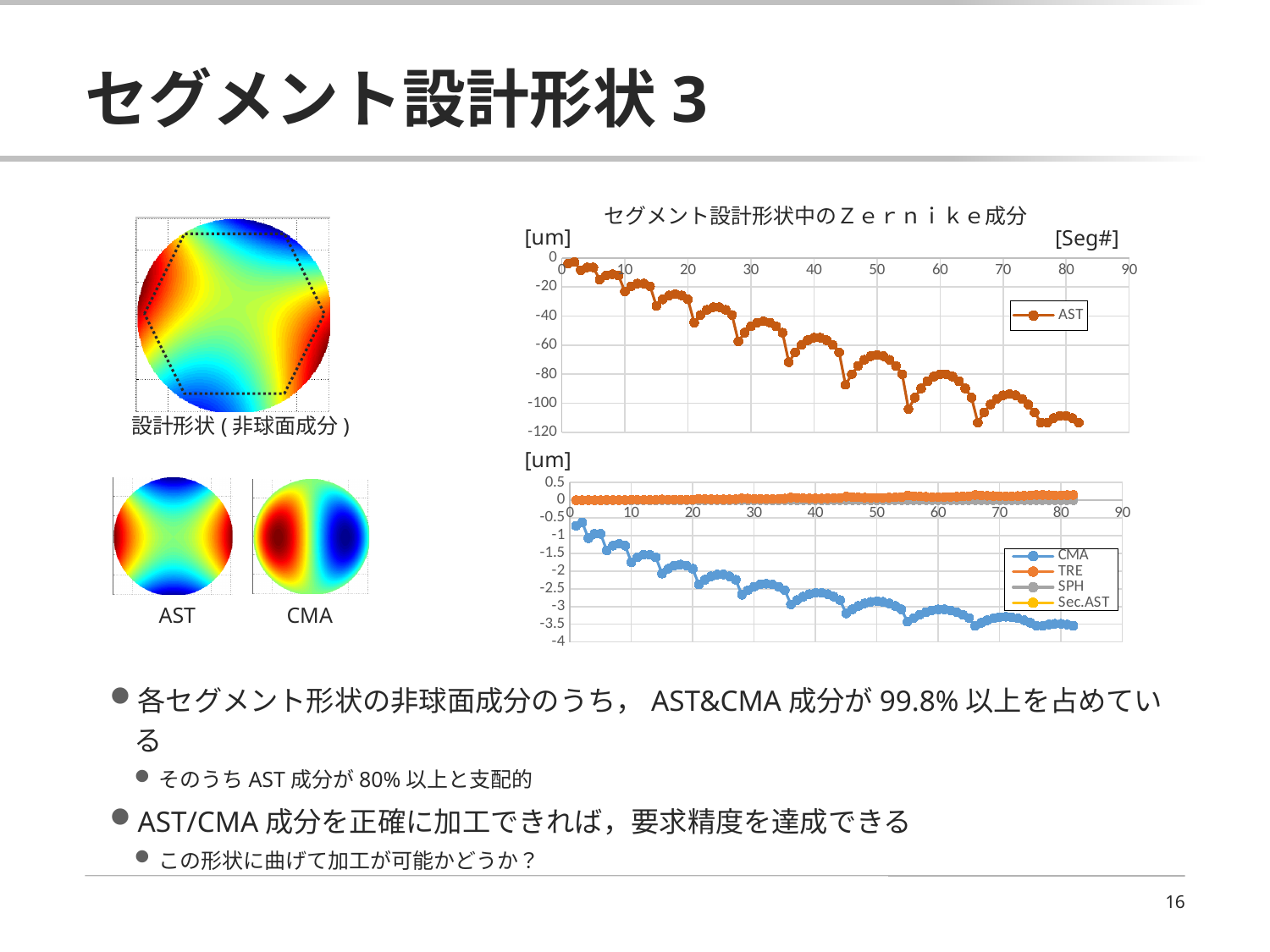
In the bottom chart on the right, is the CMA value at segment 10 greater or less than -2? greater How many series does the legend of the bottom chart on the right list? 4 In the top chart on the right, is the AST value at segment 40 greater or less than -80? greater How many series does the legend of the top chart on the right list? 1 Which series are listed in the legend of the bottom chart on the right? CMA, TRE, SPH, Sec.AST In the bottom chart on the right, is the CMA value at segment 80 greater or less than -3? less In the top chart on the right, does the AST value generally rise or fall as the segment number increases? fall What type of chart is the top chart on the right (the AST chart)? line chart What is the title of the chart on the right side of the slide? セグメント設計形状中のＺｅｒｎｉｋｅ成分 In the bottom chart on the right, does the CMA value generally rise or fall as the segment number increases? fall